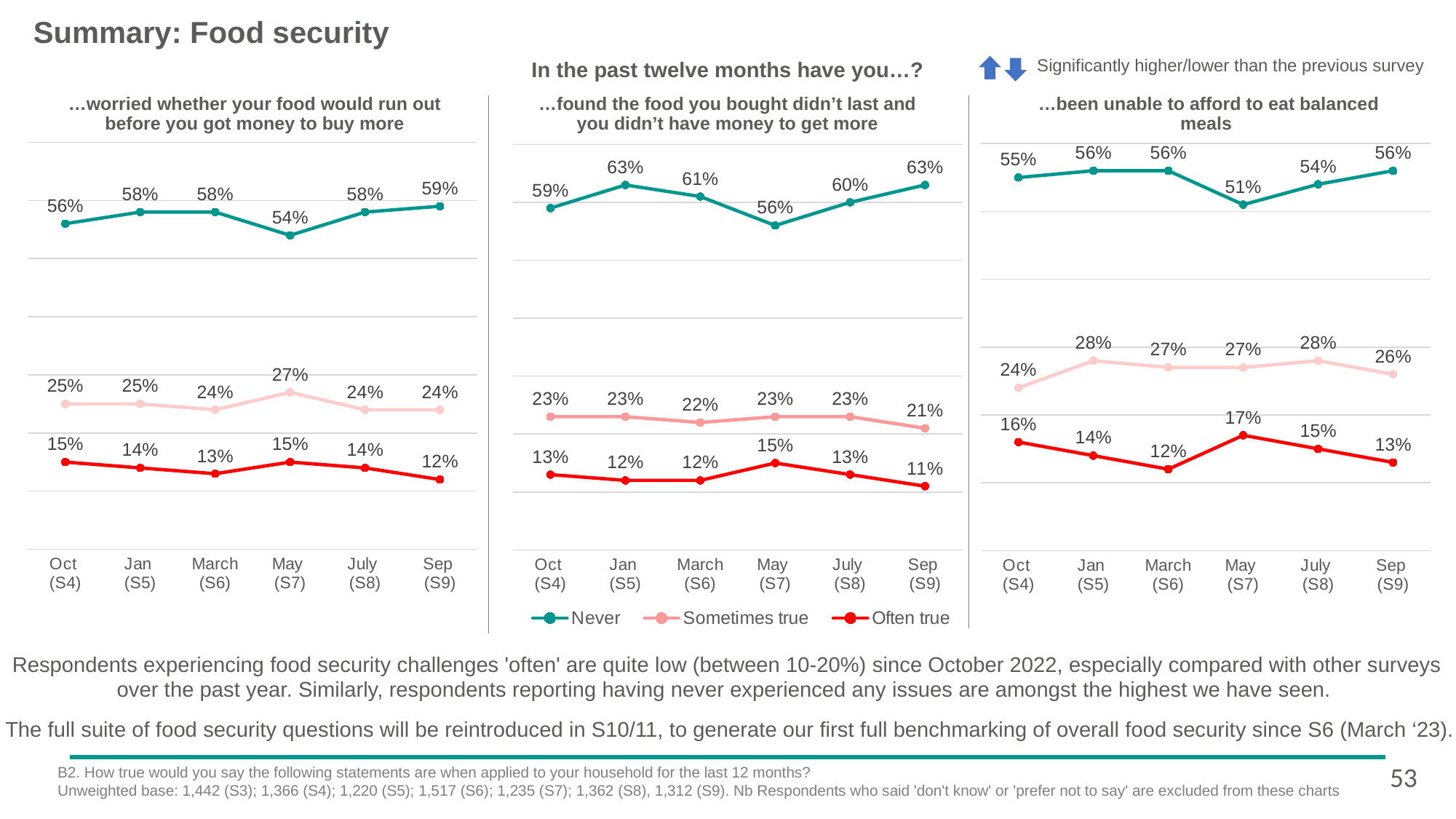
What type of chart is used for '…worried whether your food would run out before you got money to buy more'? Line chart In the chart '…worried whether your food would run out before you got money to buy more', what is the value for 'Never' in May (S7)? 54% In the chart '…found the food you bought didn't last and you didn't have money to get more', does the 'Often true' value rise or fall from July (S8) to Sep (S9)? Fall In the chart '…worried whether your food would run out before you got money to buy more', what is the difference between the 'Never' values in Sep (S9) and May (S7)? 5 percentage points In the chart '…found the food you bought didn't last and you didn't have money to get more', what is the value for 'Often true' in May (S7)? 15% How many survey waves are shown on the x axis of each chart? 6 In the chart '…found the food you bought didn't last and you didn't have money to get more', which is larger: the 'Never' value in Jan (S5) or in March (S6)? Jan (S5) How many series does the legend list? 3 In the chart '…been unable to afford to eat balanced meals', what is the difference between the 'Often true' values in May (S7) and March (S6)? 5 percentage points In the chart '…been unable to afford to eat balanced meals', what is the value for 'Sometimes true' in Oct (S4)? 24% In the chart '…been unable to afford to eat balanced meals', in which survey wave is the 'Never' value lowest? May (S7) In the chart '…found the food you bought didn't last and you didn't have money to get more', in which survey wave is the 'Often true' value highest? May (S7)